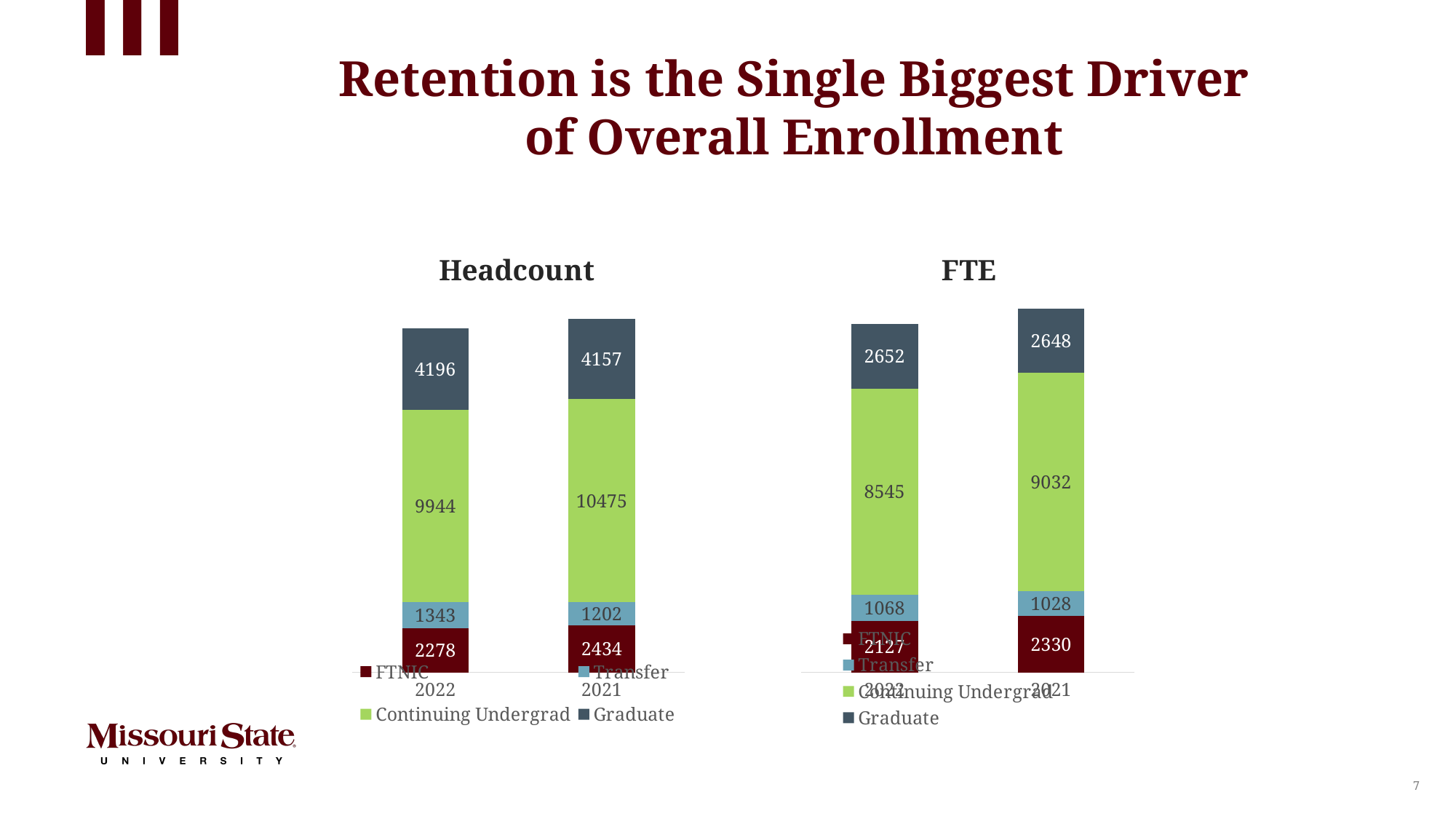
In the Headcount chart, what is the Graduate value for 2022? 4196 In the Headcount chart, what is the difference between the Continuing Undergrad values for 2021 and 2022? 531 In the Headcount chart, what is the total of the stacked bar for 2021? 18268 What kind of chart is the FTE chart? Stacked bar chart In the FTE chart, which segment is the largest in the 2021 bar? Continuing Undergrad In the FTE chart, what is the difference between the FTNIC values for 2021 and 2022? 203 In the FTE chart, what is the Continuing Undergrad value for 2022? 8545 In the Headcount chart, which year has the larger Transfer value, 2022 or 2021? 2022 In the Headcount chart, what is the Continuing Undergrad value for 2021? 10475 In the FTE chart, what is the total of the stacked bar for 2021? 15038 How many series does the legend of the Headcount chart list? 4 In the FTE chart, what is the Transfer value for 2021? 1028